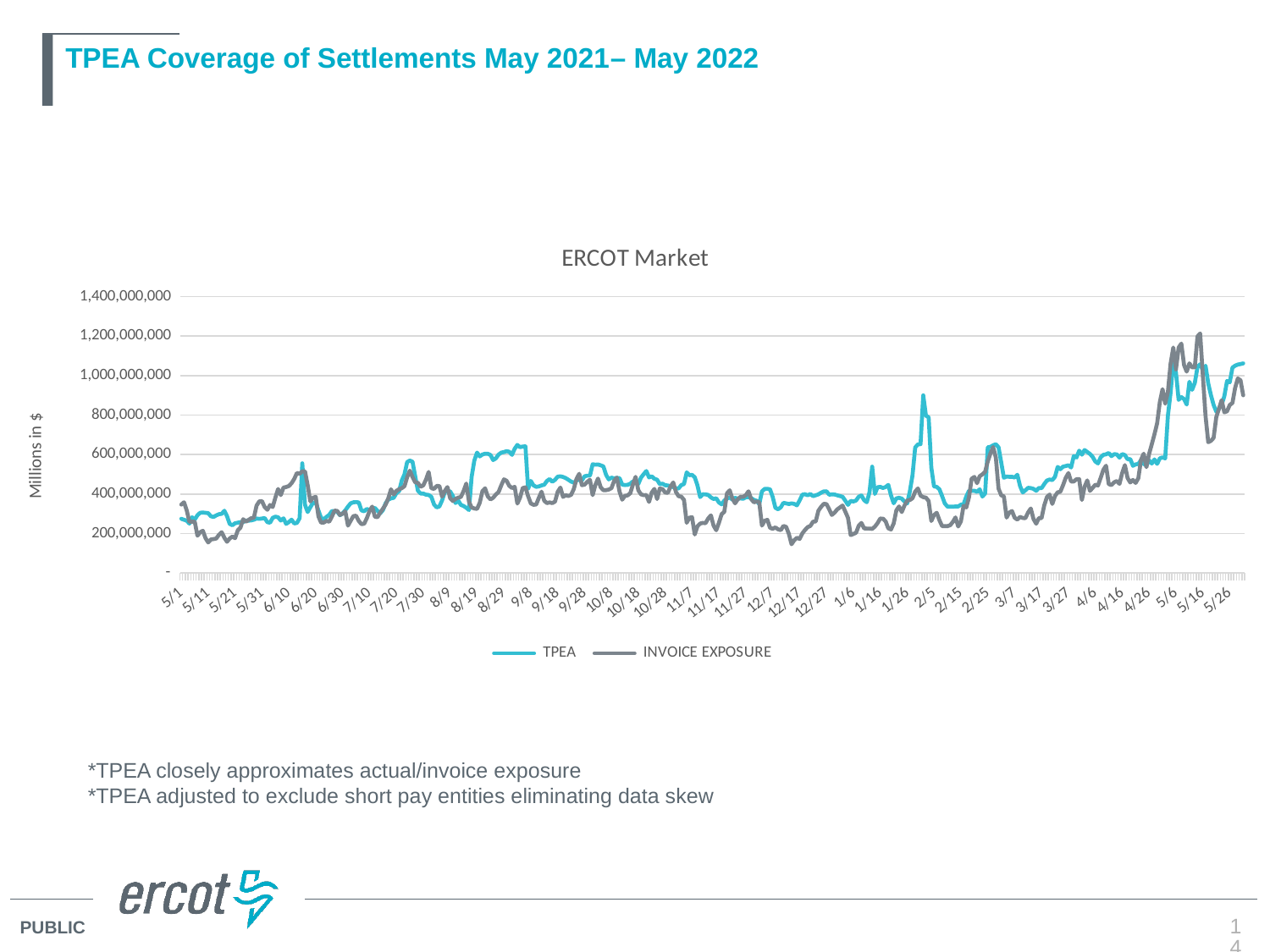
Around 2/5, which series has the larger value, TPEA or INVOICE EXPOSURE? TPEA What is the title of the chart? ERCOT Market Is the TPEA value at 5/1 greater or less than 400,000,000? less Which series reaches the highest value anywhere on the chart? INVOICE EXPOSURE Around 8/29, which series has the larger value, TPEA or INVOICE EXPOSURE? TPEA Is the peak value of INVOICE EXPOSURE around 5/16 greater or less than 1,000,000,000? greater What kind of chart is shown on the slide? line chart What is the label on the vertical axis of the chart? Millions in $ Is the INVOICE EXPOSURE value around 12/17 greater or less than 200,000,000? less How many series does the chart legend list? 2 Overall, do the TPEA values rise or fall from 5/1 to 5/26 along the x axis? rise